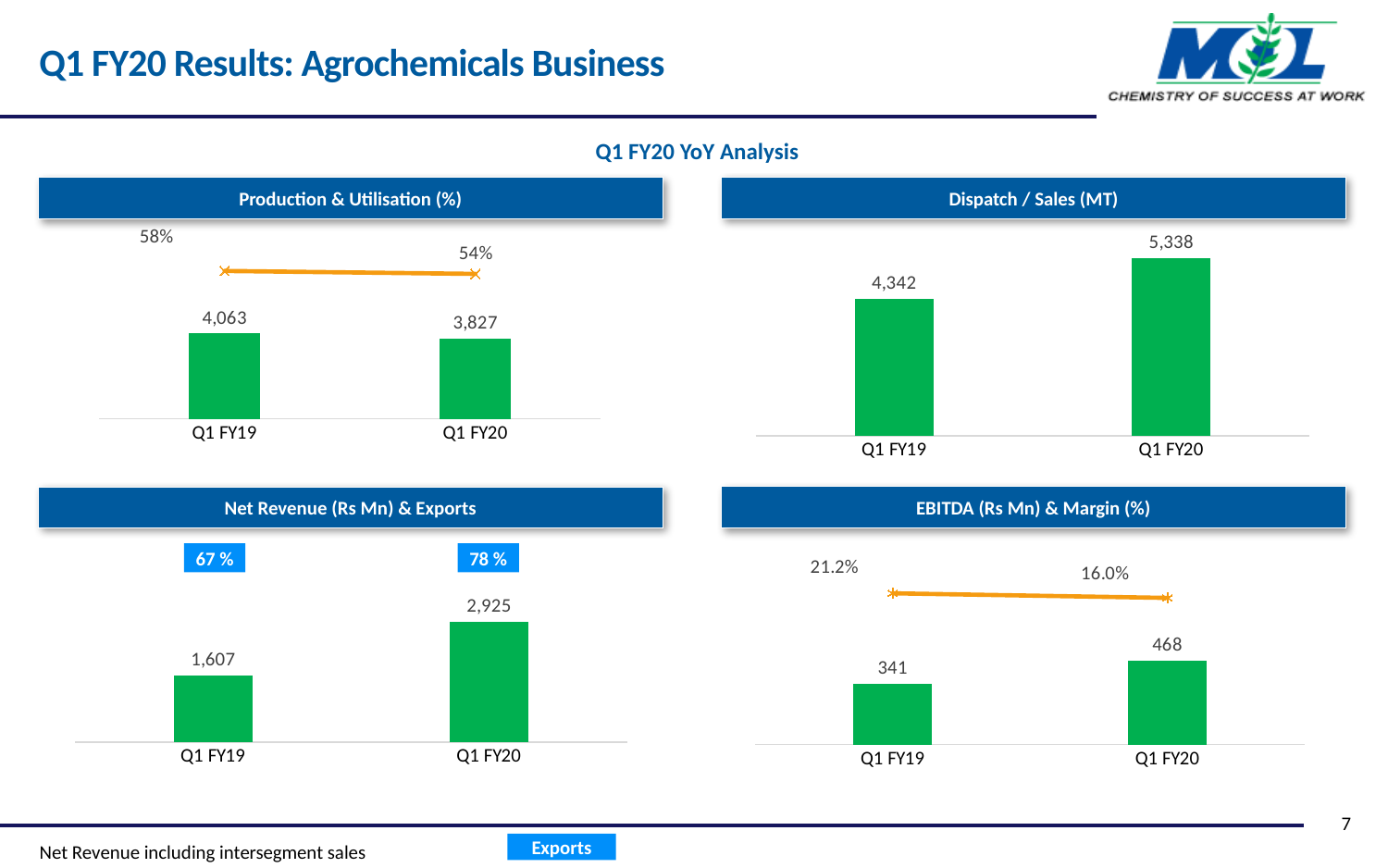
How many charts are shown on the slide? 4 In the Production & Utilisation (%) chart, does the utilisation percentage rise or fall from Q1 FY19 to Q1 FY20? fall In the Production & Utilisation (%) chart, what is the utilisation percentage for Q1 FY20? 54% In the Net Revenue (Rs Mn) & Exports chart, what is the difference in net revenue between Q1 FY20 and Q1 FY19? 1,318 In the EBITDA (Rs Mn) & Margin (%) chart, what is the margin for Q1 FY19? 21.2% In the EBITDA (Rs Mn) & Margin (%) chart, which quarter has the higher EBITDA? Q1 FY20 In the EBITDA (Rs Mn) & Margin (%) chart, what is the EBITDA for Q1 FY20? 468 In the Net Revenue (Rs Mn) & Exports chart, what is the net revenue for Q1 FY19? 1,607 In the Net Revenue (Rs Mn) & Exports chart, what is the exports share for Q1 FY20? 78 % In the Dispatch / Sales (MT) chart, what is the difference between Q1 FY20 and Q1 FY19? 996 In the Production & Utilisation (%) chart, what is the production value for Q1 FY19? 4,063 In the Dispatch / Sales (MT) chart, what is the value for Q1 FY20? 5,338